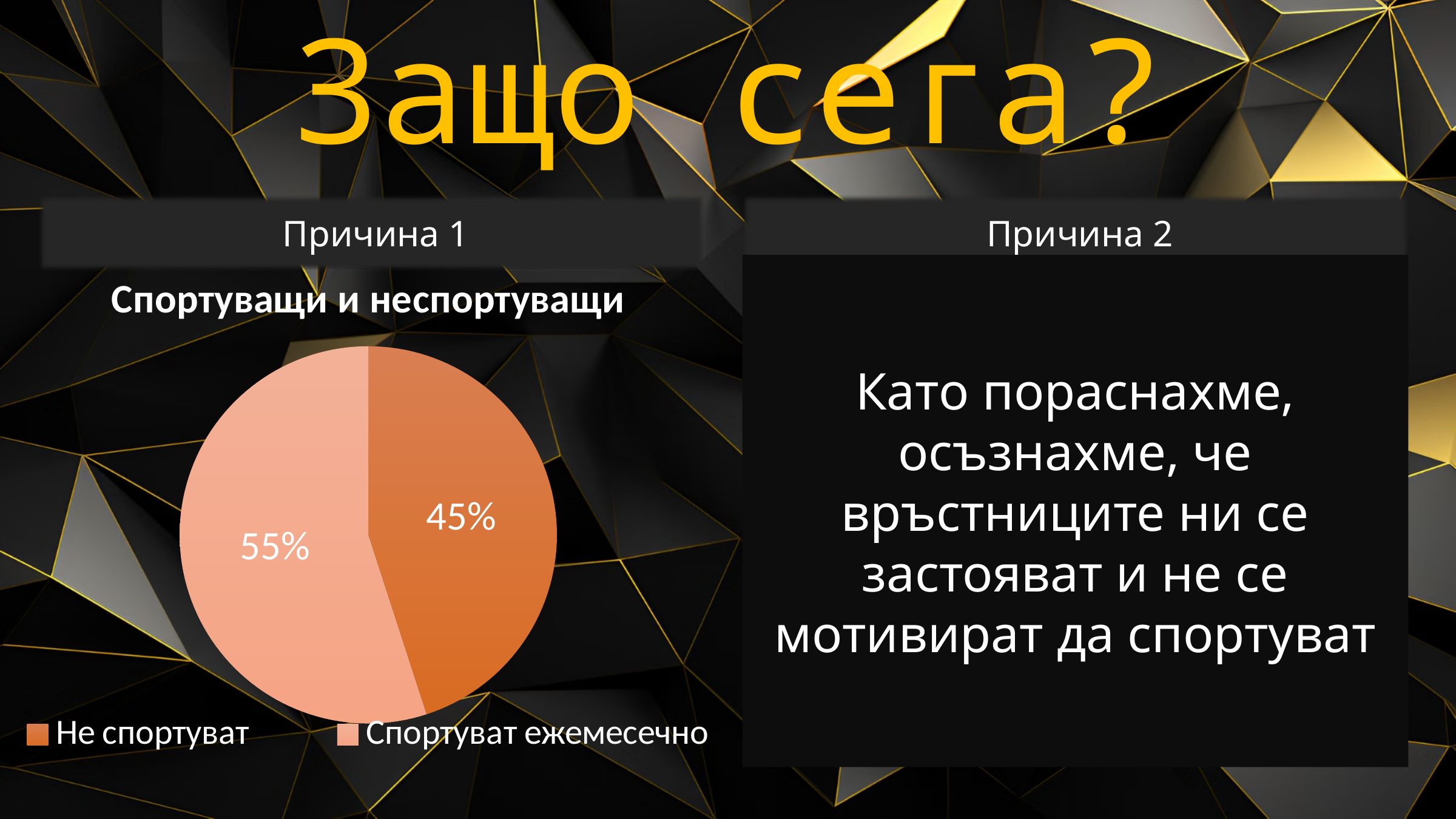
What share of the pie is labelled "Не спортуват"? 45% Which is larger: the share for "Не спортуват" or the share for "Спортуват ежемесечно"? Спортуват ежемесечно Which legend entry is shown in the darker orange colour? Не спортуват What is the difference in percentage points between the "Спортуват ежемесечно" slice and the "Не спортуват" slice? 10% How many slices does the pie chart have? 2 What kind of chart is shown on the slide? pie chart How many entries does the chart legend list? 2 What is the title of the chart? Спортуващи и неспортуващи Which slice of the pie is the largest? Спортуват ежемесечно Which slice of the pie is the smallest? Не спортуват What share of the pie is labelled "Спортуват ежемесечно"? 55%